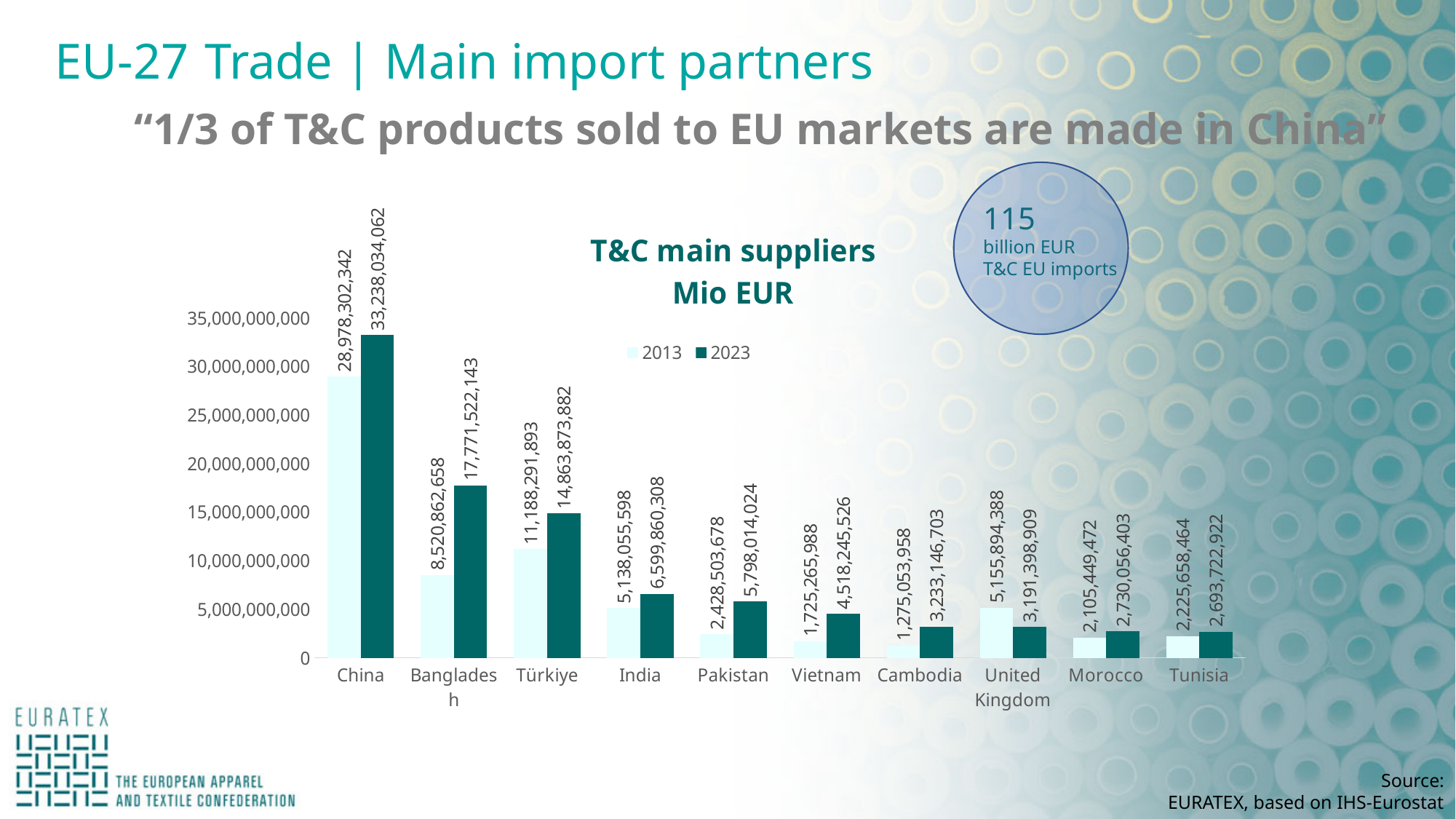
Which country has the highest 2023 value in the T&C main suppliers chart? China How many series does the legend of the T&C main suppliers chart list? 2 What is the difference between Bangladesh's 2023 and 2013 values in the T&C main suppliers chart? 9,250,659,485 What is the 2023 value for China in the T&C main suppliers chart? 33,238,034,062 What is the 2013 value for Bangladesh in the T&C main suppliers chart? 8,520,862,658 How many countries are shown on the x axis of the T&C main suppliers chart? 10 Which country has the lowest 2013 value in the T&C main suppliers chart? Cambodia What is the 2013 value for the United Kingdom in the T&C main suppliers chart? 5,155,894,388 By how much did China's value increase from 2013 to 2023 in the T&C main suppliers chart? 4,259,731,720 What type of chart is the T&C main suppliers chart? Bar chart For the United Kingdom, which year has the larger value in the T&C main suppliers chart, 2013 or 2023? 2013 What is the 2023 value for Vietnam in the T&C main suppliers chart? 4,518,245,526